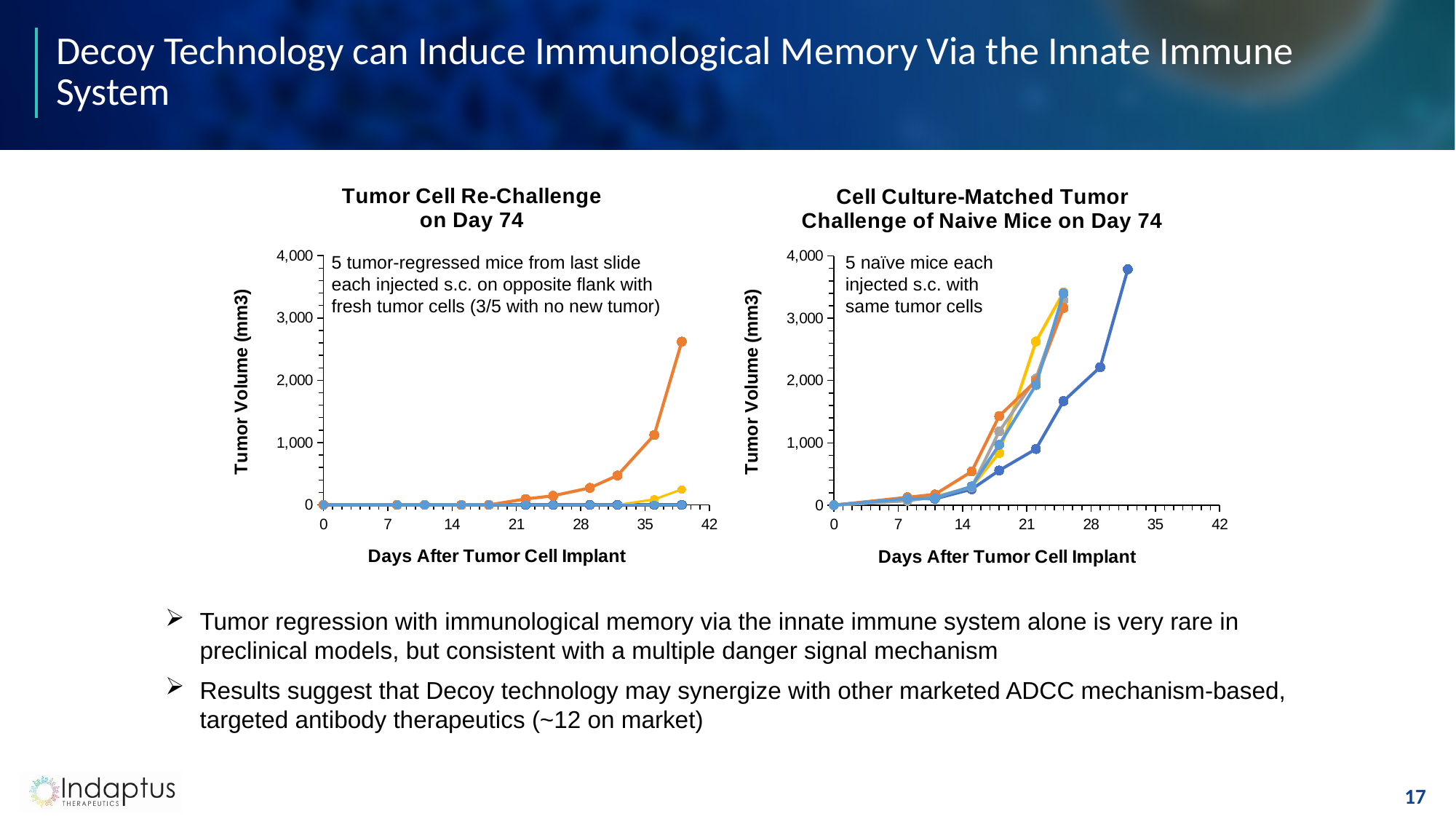
What is the y-axis label on the 'Tumor Cell Re-Challenge on Day 74' chart? Tumor Volume (mm3) What is the x-axis label on the 'Cell Culture-Matched Tumor Challenge of Naive Mice on Day 74' chart? Days After Tumor Cell Implant In the 'Cell Culture-Matched Tumor Challenge of Naive Mice on Day 74' chart, is the highest value of the dark blue line greater or less than 3,000? greater What kind of chart is the 'Tumor Cell Re-Challenge on Day 74' chart? Line chart In the 'Cell Culture-Matched Tumor Challenge of Naive Mice on Day 74' chart, do the tumor volumes rise or fall as days increase? Rise In the 'Tumor Cell Re-Challenge on Day 74' chart, is the final value of the orange line greater or less than 3,000? less In the 'Cell Culture-Matched Tumor Challenge of Naive Mice on Day 74' chart, are all lines greater or less than 1,000 at day 14? less In the 'Cell Culture-Matched Tumor Challenge of Naive Mice on Day 74' chart, which coloured line reaches the highest tumor volume? Dark blue In the 'Tumor Cell Re-Challenge on Day 74' chart, which coloured line reaches the highest tumor volume? Orange What kind of chart is the 'Cell Culture-Matched Tumor Challenge of Naive Mice on Day 74' chart? Line chart